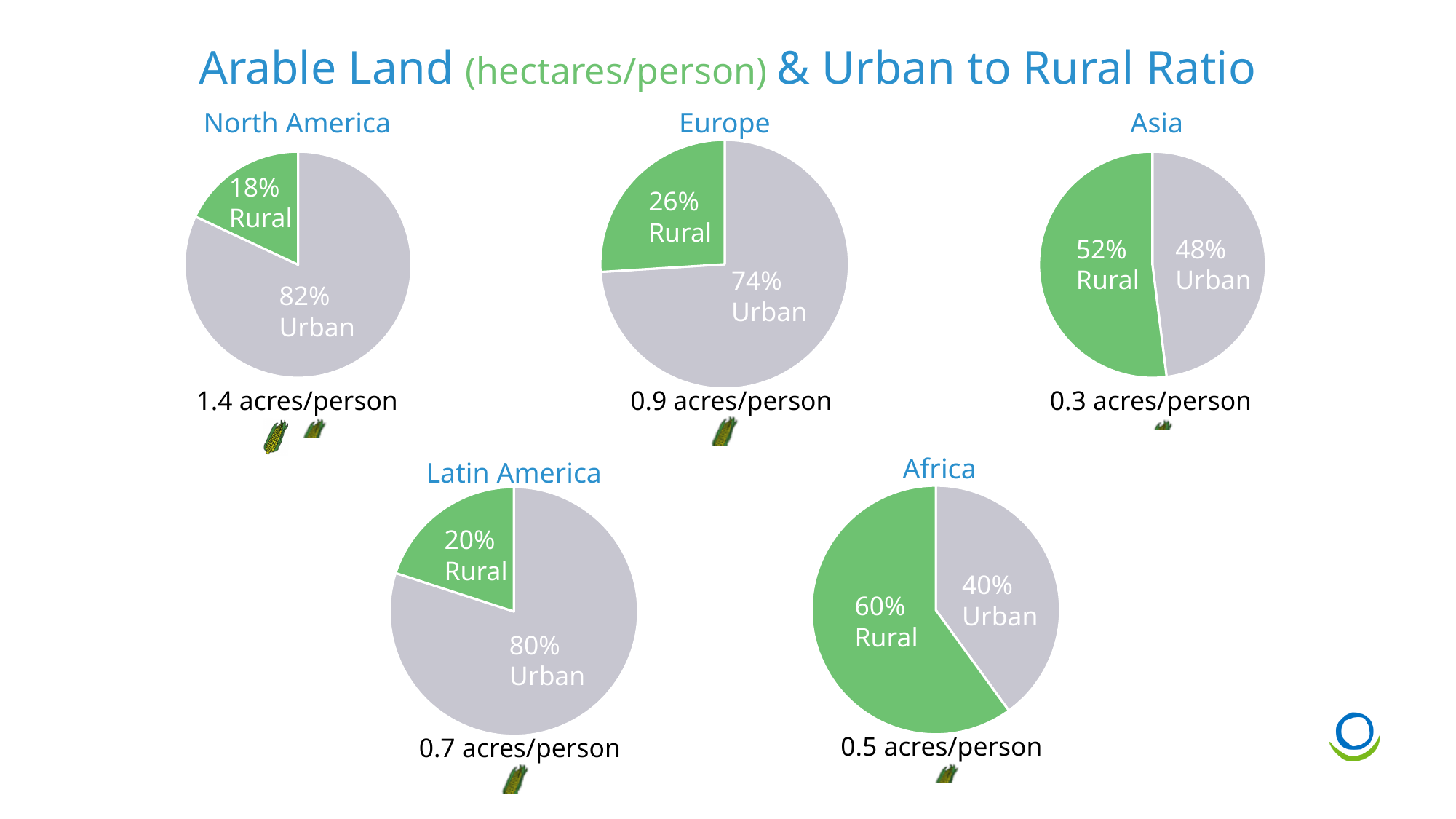
Comparing the Europe and Latin America pie charts, which region has the larger Rural share? Europe Across the five pie charts, which region has the highest Rural share? Africa How many pie charts are shown on the slide? 5 What kind of chart is used for each region on the slide? Pie chart In the Africa pie chart, what share of the population is Rural? 60% In the North America pie chart, what share of the population is Rural? 18% Across the five pie charts, which region has the lowest Rural share? North America In the Europe pie chart, what share of the population is Urban? 74% In the Africa pie chart, what is the difference between the Rural and Urban shares? 20% What colour represents the Rural slice in the pie charts? Green